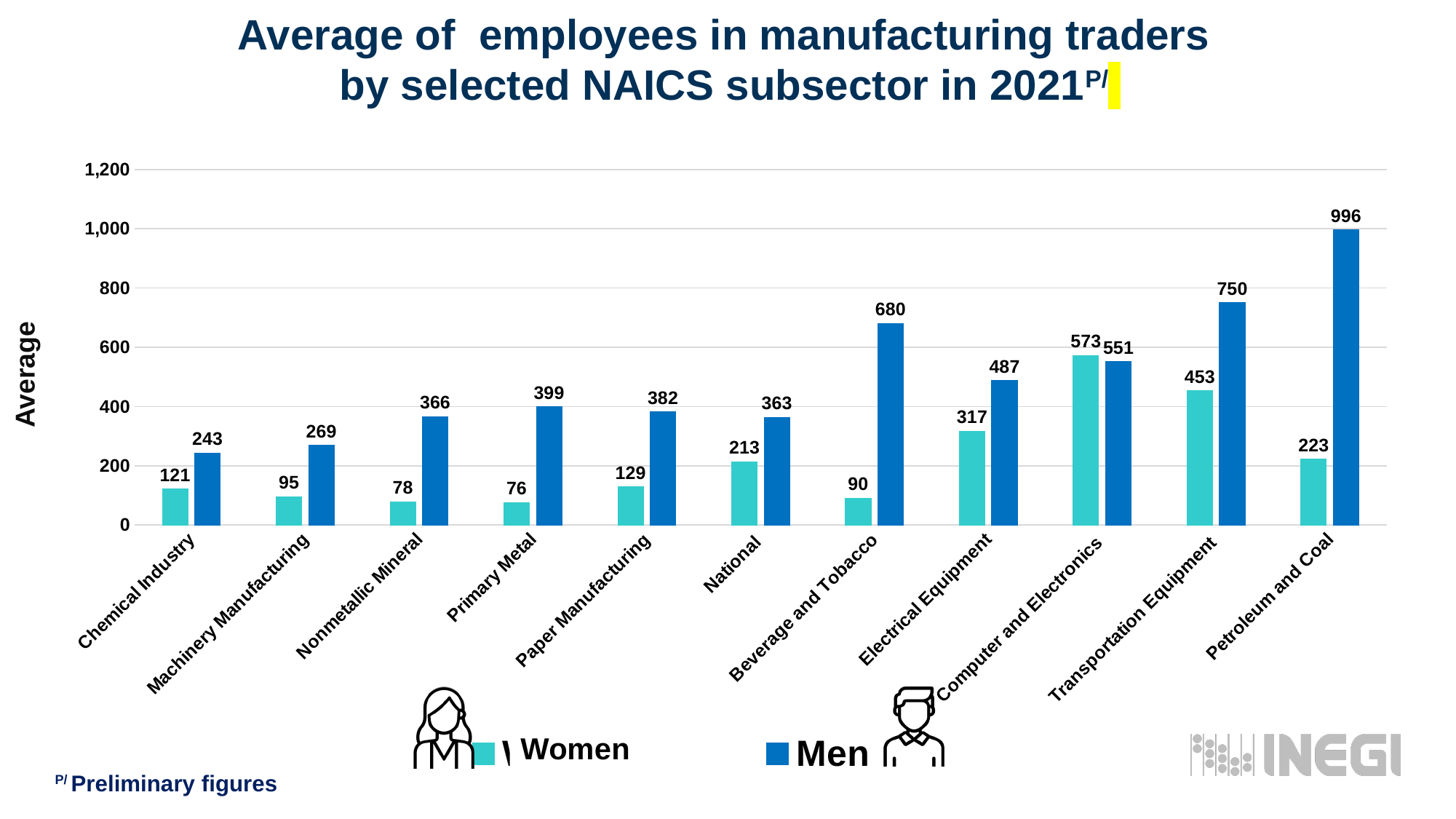
How many series does the legend list? 2 Which subsector has the highest average number of men employees? Petroleum and Coal Which is larger in Computer and Electronics, the Women value or the Men value? Women Which subsector has the lowest average number of women employees? Primary Metal What is the total of the Women and Men values for National? 576 What kind of chart is shown on the slide? Bar chart Is the value for men in Transportation Equipment greater or less than 600? greater How many subsector categories are shown on the x axis? 11 What is the difference between men and women employees in Beverage and Tobacco? 590 What is the average number of women employees in the Chemical Industry? 121 What is the average number of women employees in Computer and Electronics? 573 What is the average number of men employees in Petroleum and Coal? 996